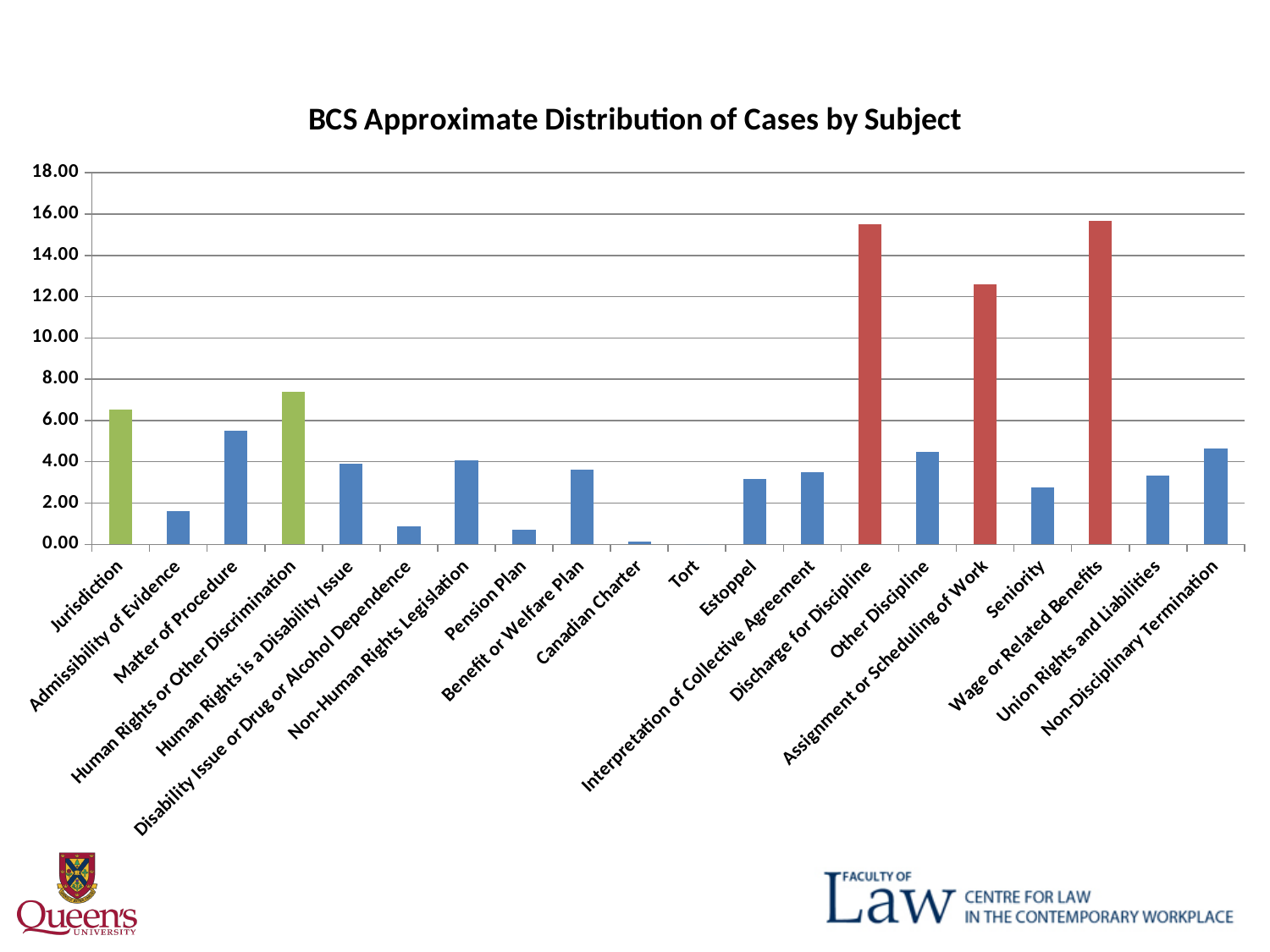
Which is larger, the value for Jurisdiction or the value for Matter of Procedure? Jurisdiction Is the value for Seniority greater or less than 2.00? greater Is the value for Pension Plan greater or less than 2.00? less Is the value for Human Rights or Other Discrimination greater or less than 8.00? less What is the highest value shown on the vertical axis? 18.00 What is the title of the chart? BCS Approximate Distribution of Cases by Subject Which is larger, the value for Assignment or Scheduling of Work or the value for Other Discipline? Assignment or Scheduling of Work What kind of chart is shown on the slide? Bar chart How many subject categories are plotted on the x axis? 20